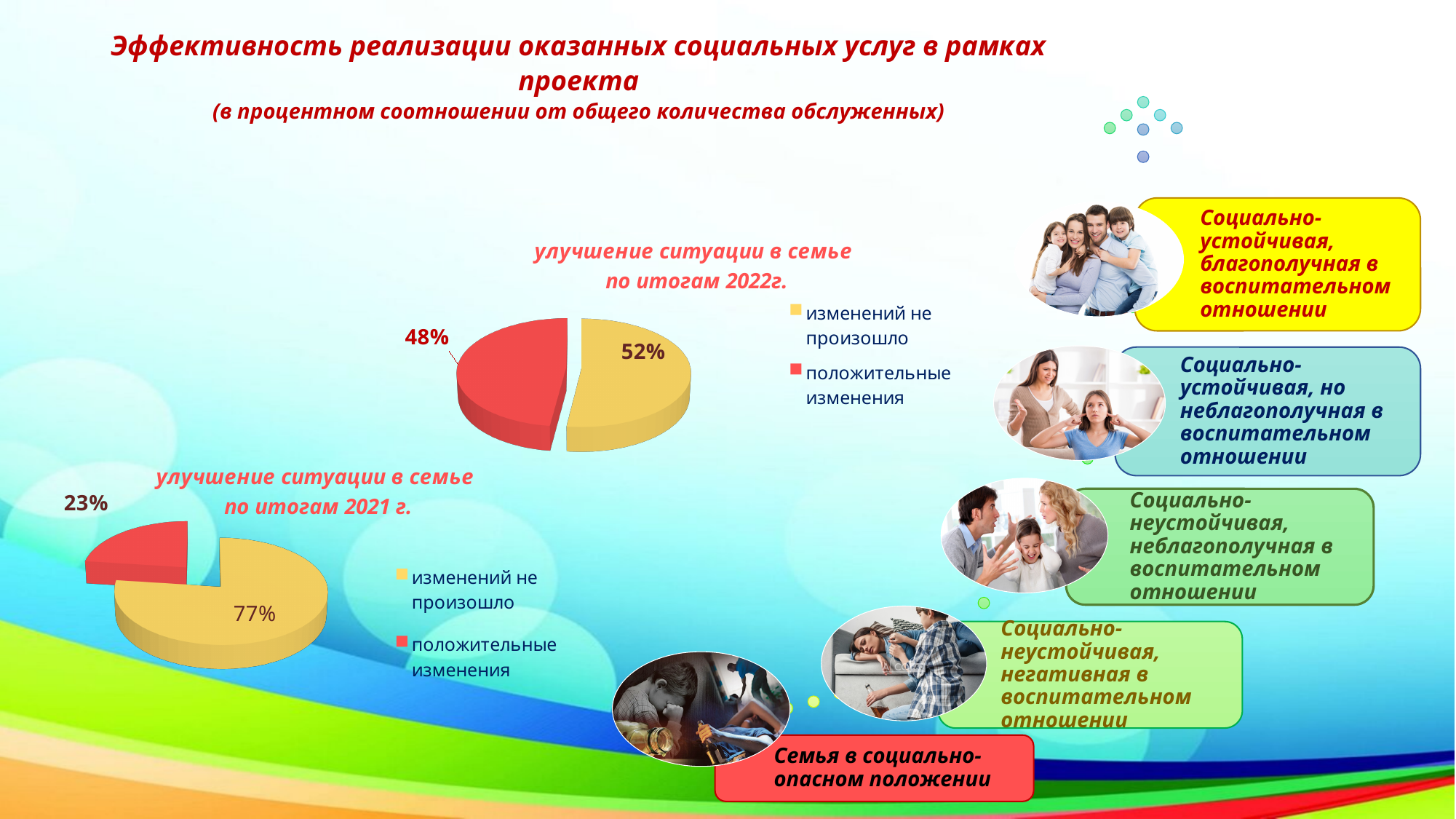
In the chart 'улучшение ситуации в семье по итогам 2022г.', what share is labelled for 'положительные изменения'? 48% In the chart 'улучшение ситуации в семье по итогам 2022г.', what colour is the 'положительные изменения' slice? red In the chart 'улучшение ситуации в семье по итогам 2021 г.', which category has the largest slice? изменений не произошло In the chart 'улучшение ситуации в семье по итогам 2021 г.', what share is labelled for 'изменений не произошло'? 77% In the chart 'улучшение ситуации в семье по итогам 2022г.', what share is labelled for 'изменений не произошло'? 52% In the chart 'улучшение ситуации в семье по итогам 2021 г.', what share is labelled for 'положительные изменения'? 23% In the chart 'улучшение ситуации в семье по итогам 2021 г.', what is the difference between the 'изменений не произошло' and 'положительные изменения' slices? 54% What type of chart is 'улучшение ситуации в семье по итогам 2022г.'? pie chart Which is larger: the 'положительные изменения' share in the 2022 chart or in the 2021 chart? 2022 chart How many slices does the chart 'улучшение ситуации в семье по итогам 2021 г.' have? 2 In the chart 'улучшение ситуации в семье по итогам 2022г.', what is the difference between the 'изменений не произошло' and 'положительные изменения' slices? 4% In the chart 'улучшение ситуации в семье по итогам 2022г.', which category has the smallest slice? положительные изменения